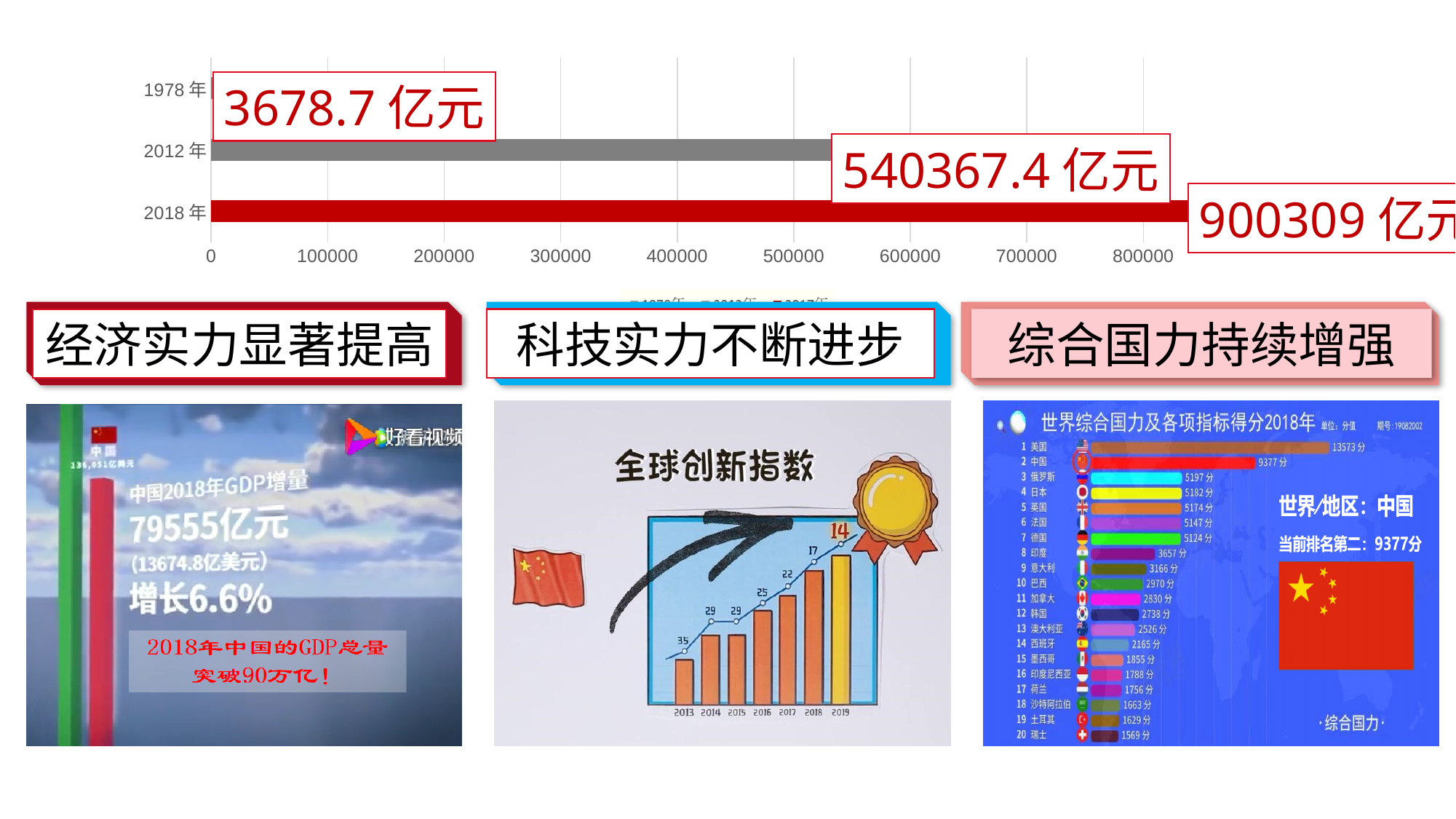
In the top bar chart, what is the value for 2018年? 900309 亿元 In the top bar chart, which year has the highest value? 2018年 In the top bar chart, what is the difference between the values for 2018年 and 2012年? 359941.6 亿元 In the top bar chart, which year has the lowest value? 1978年 What kind of chart is the chart at the top of the slide? bar chart In the top bar chart, do the values rise or fall from 1978年 to 2018年? rise In the 全球创新指数 chart in the middle image, what is the value for 2019? 14 How many years are shown in the top bar chart? 3 In the top bar chart, what is the value for 1978年? 3678.7 亿元 In the top bar chart, is the value for 2012年 greater or less than 500000? greater In the top bar chart, what is the value for 2012年? 540367.4 亿元 In the top bar chart, which is larger, the value for 2012年 or the value for 1978年? 2012年